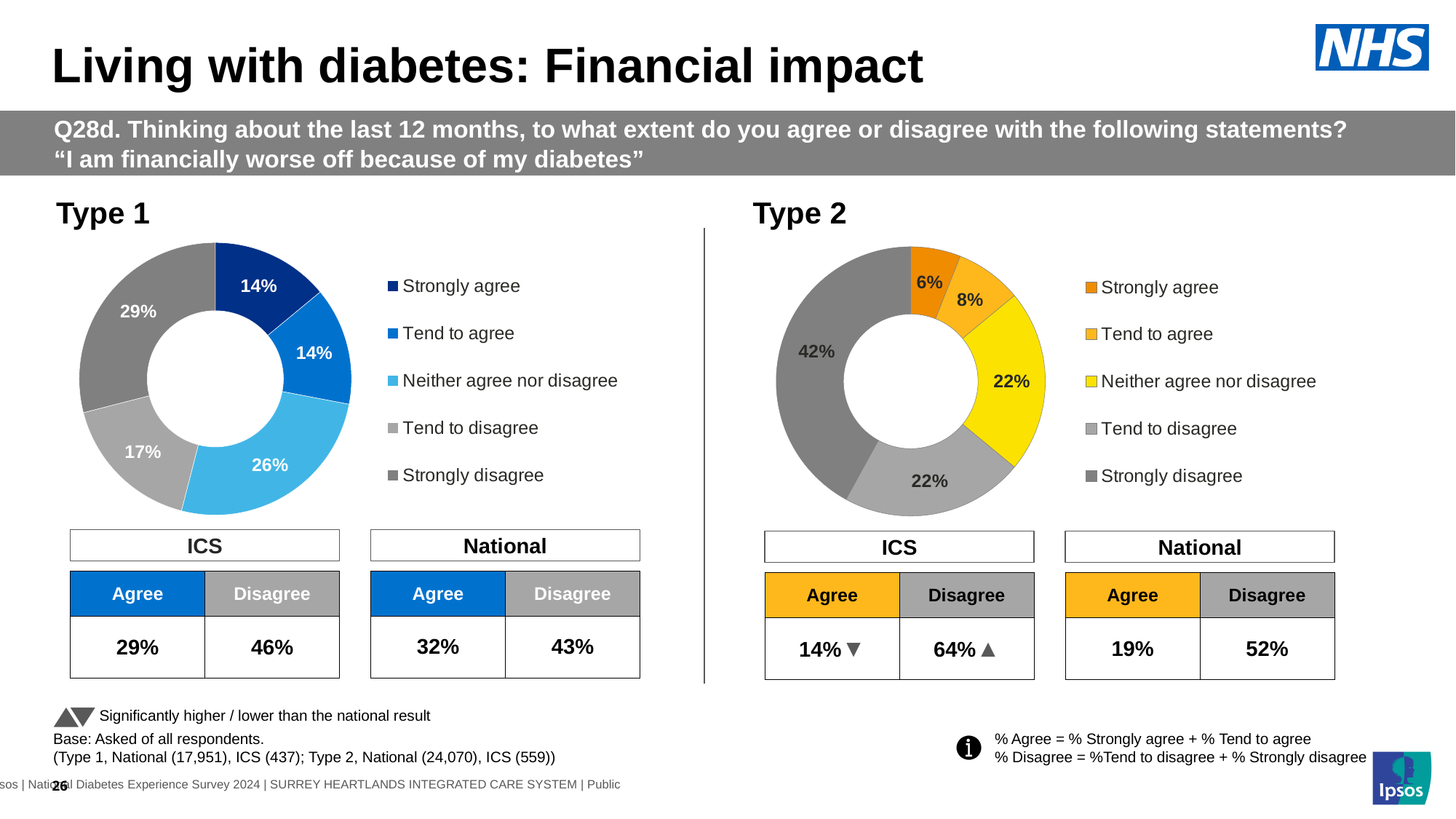
In the Type 2 chart, what percentage of respondents said they strongly agree? 6% Which is larger in the Type 1 chart: the share for Neither agree nor disagree or the share for Tend to disagree? Neither agree nor disagree In the Type 1 chart, what is the difference in percentage points between Strongly disagree and Tend to disagree? 12 What kind of chart is used to show the Type 1 results? Donut (pie) chart In the Type 2 chart, what is the difference in percentage points between Strongly disagree and Neither agree nor disagree? 20 How many response categories does the legend of the Type 2 chart list? 5 In the Type 2 chart, which response category has the largest share? Strongly disagree In the Type 2 chart, which response category has the smallest share? Strongly agree In the Type 1 chart, what percentage of respondents said they neither agree nor disagree? 26% In the Type 1 chart, which response category has the largest share? Strongly disagree In the Type 2 chart, what percentage of respondents said they tend to agree? 8% In the Type 1 chart, what percentage of respondents said they strongly disagree? 29%